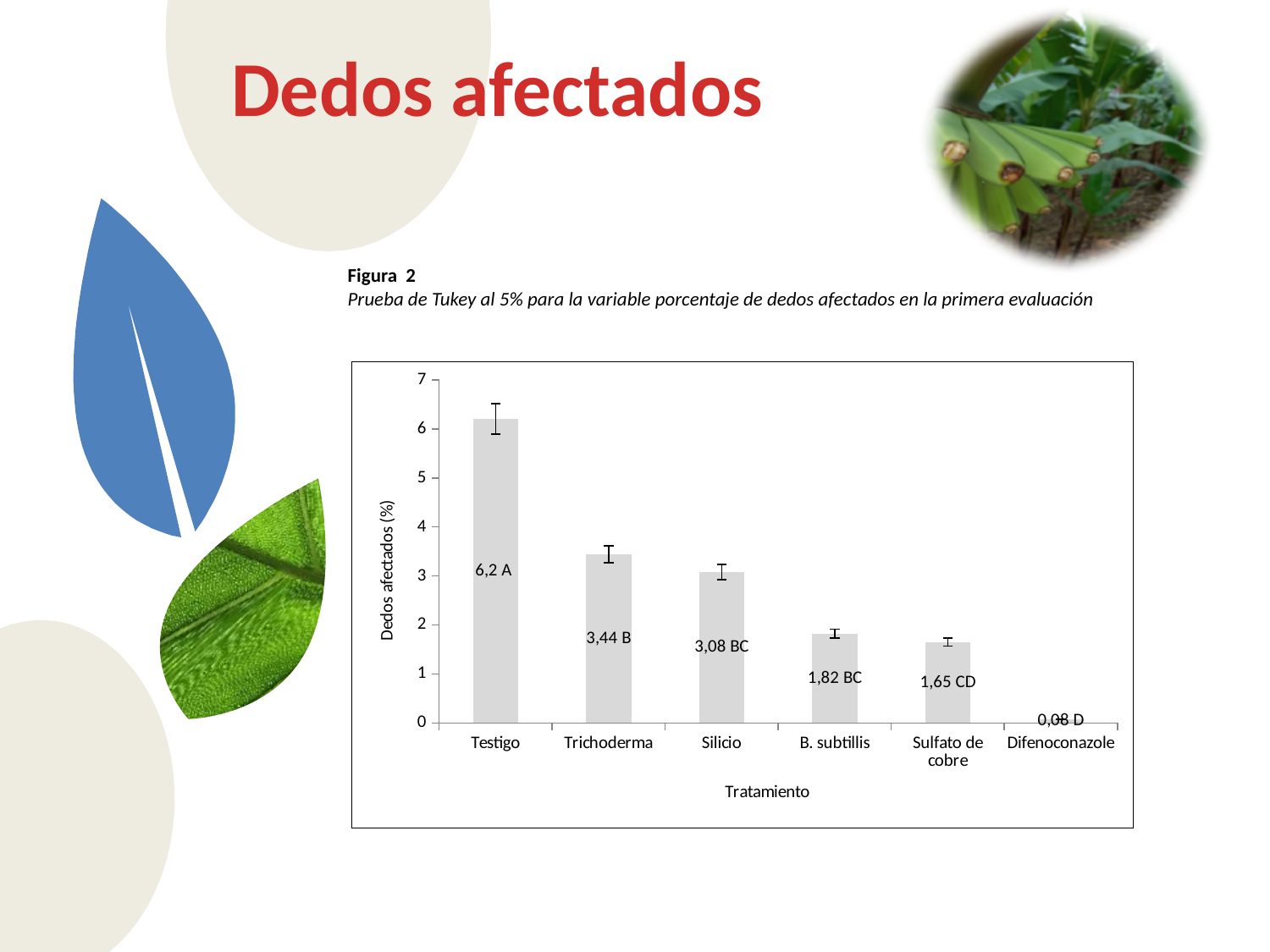
Do the values rise or fall from left to right along the x axis? fall Which treatment has the lowest percentage of affected fingers? Difenoconazole Which has a larger value, Silicio or B. subtillis? Silicio What is the value for Testigo? 6,2 How many treatments are shown on the x axis? 6 What is the value for Difenoconazole? 0,08 Which treatment has the highest percentage of affected fingers? Testigo What is the value for Sulfato de cobre? 1,65 What is the difference between the values for Testigo and Trichoderma? 2,76 Is the value for Trichoderma greater or less than 4? less What type of chart is shown on the slide? bar chart What is the value for Trichoderma? 3,44